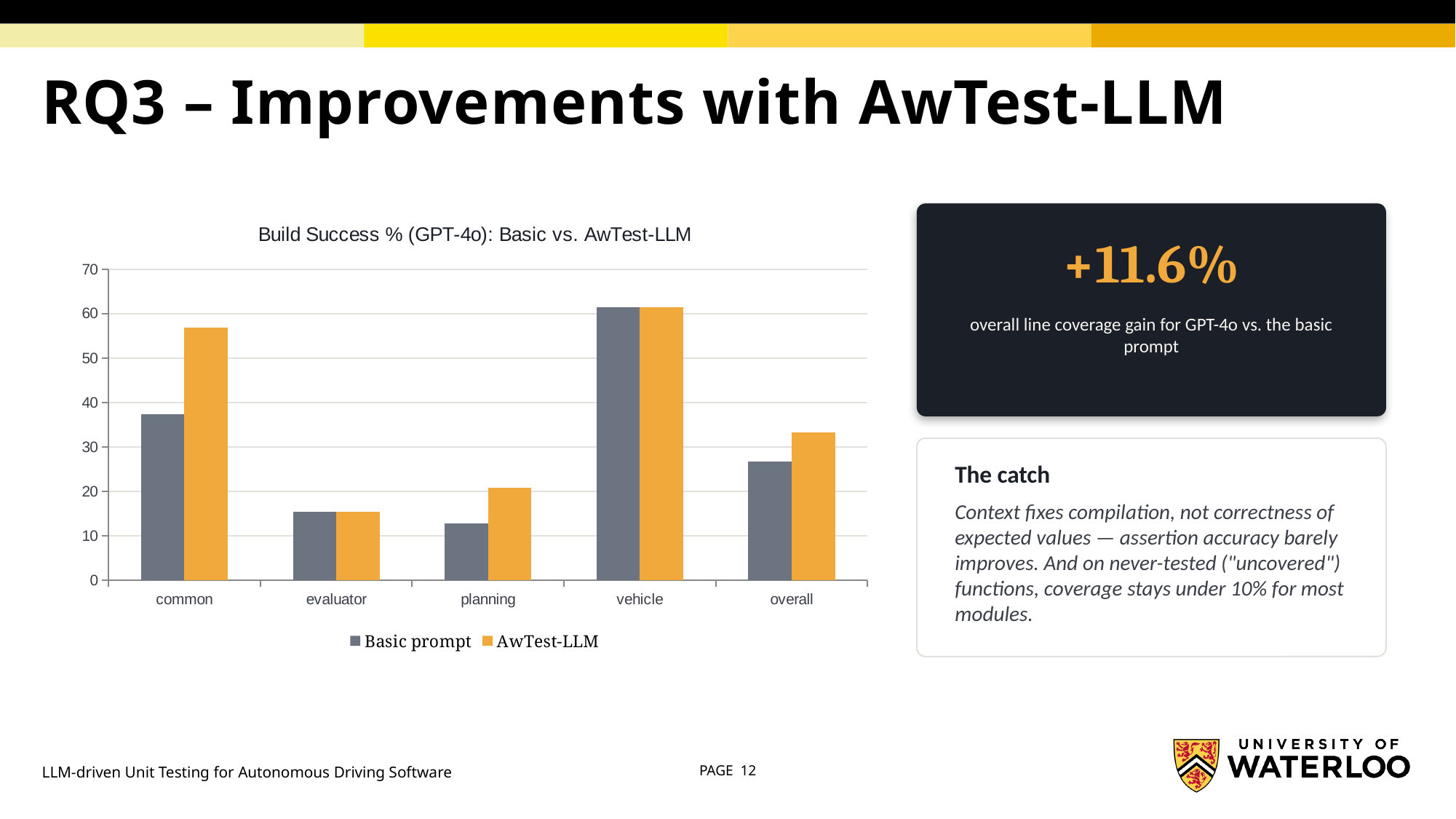
Which category has the lowest Basic prompt build success value? planning Is the Basic prompt value for planning greater or less than 20? less What is the title of the chart? Build Success % (GPT-4o): Basic vs. AwTest-LLM What kind of chart is shown on the slide? bar chart Which category has the lowest AwTest-LLM build success value? evaluator Which category has the highest AwTest-LLM build success value? vehicle How many series does the legend of the chart list? 2 Is the Basic prompt value for vehicle greater or less than 50? greater For the common category, which series has the larger value, Basic prompt or AwTest-LLM? AwTest-LLM How many categories are shown on the x axis of the chart? 5 For the overall category, which series has the larger value, Basic prompt or AwTest-LLM? AwTest-LLM Is the AwTest-LLM value for common greater or less than 50? greater